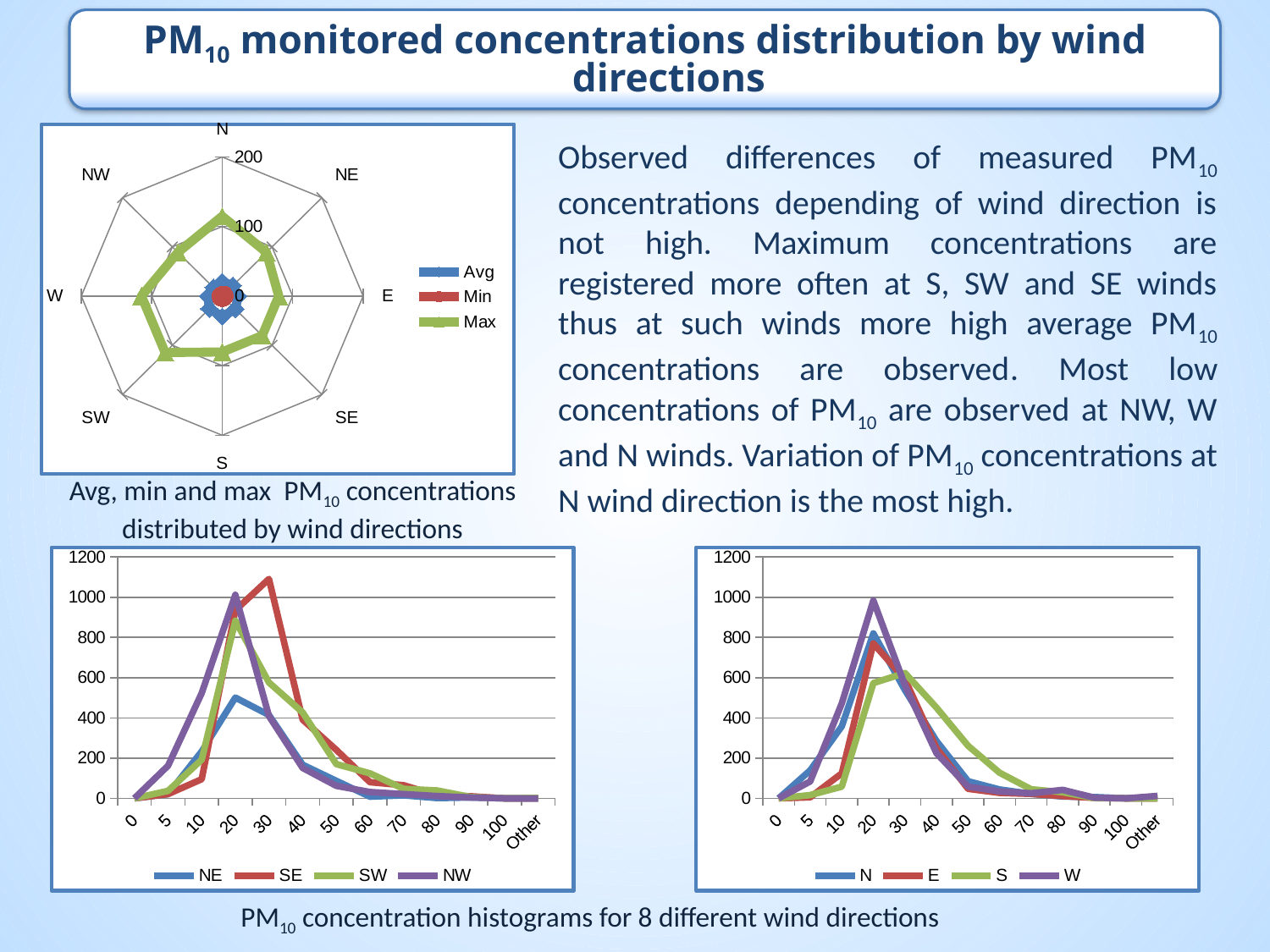
On the bottom-left line chart, which series reaches the highest peak? SE On the top-left radar chart, is the Avg value at S greater or less than 100? less On the bottom-right line chart, which is larger at 40, the S value or the E value? S How many series does the legend of the bottom-left line chart list? 4 What kind of chart is the top-left chart titled 'Avg, min and max PM10 concentrations distributed by wind directions'? radar chart On the bottom-right line chart, do the values rise or fall along the x axis from 30 to 100? fall On the top-left radar chart, which series is plotted in green? Max What kind of chart is the bottom-left chart with series NE, SE, SW and NW? line chart On the bottom-left line chart, is the SE value at 30 greater or less than 1000? greater How many series does the legend of the top-left radar chart list? 3 On the top-left radar chart, which is larger at S, the Max value or the Avg value? Max How many wind directions are plotted on the top-left radar chart? 8